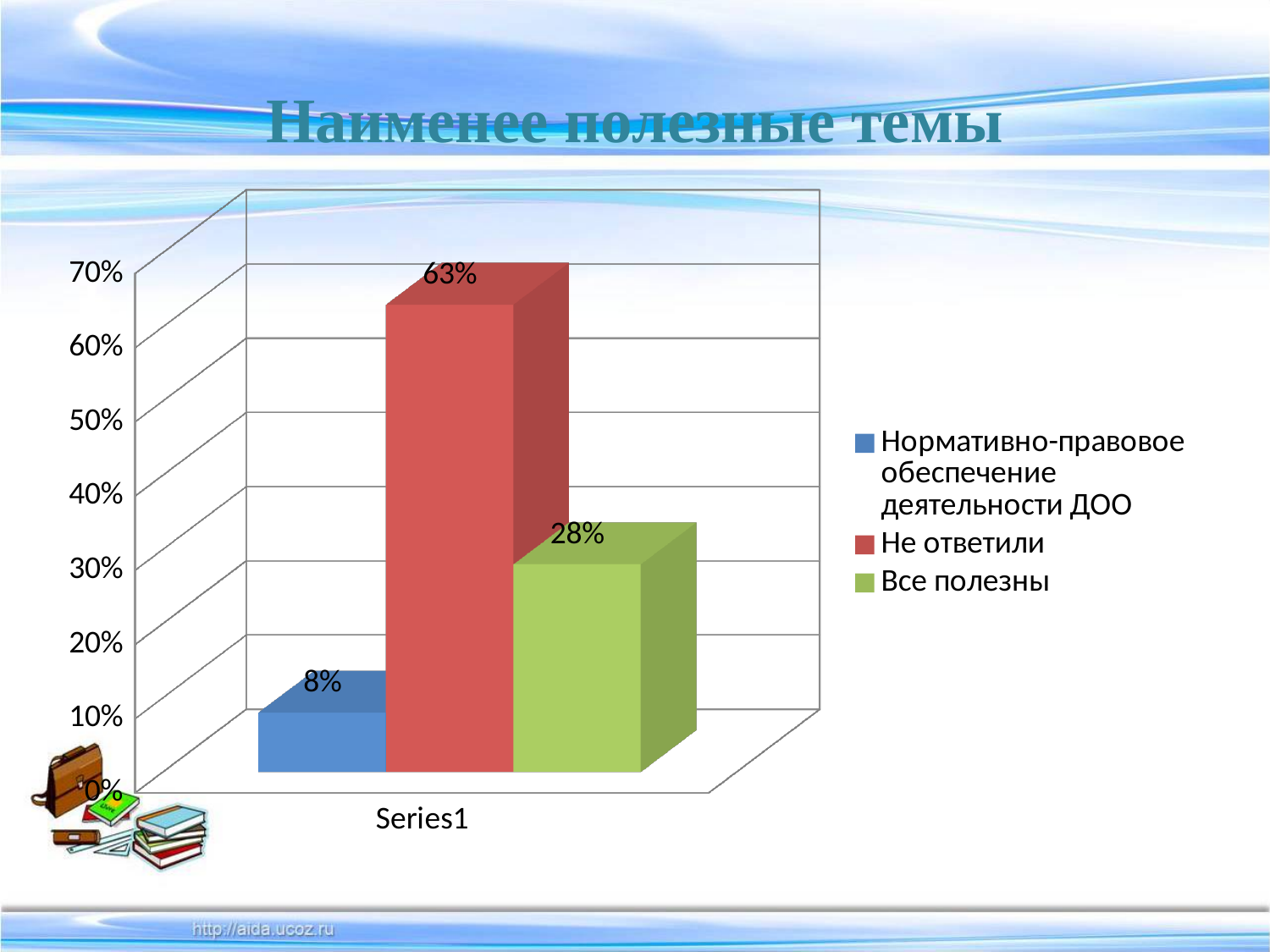
What kind of chart is shown on the slide? Bar chart What is the value for "Все полезны"? 28% What is the title of the slide? Наименее полезные темы Which series has the highest value? Не ответили What is the value for "Нормативно-правовое обеспечение деятельности ДОО"? 8% What is the difference between the values for "Все полезны" and "Нормативно-правовое обеспечение деятельности ДОО"? 20% What is the difference between the values for "Не ответили" and "Все полезны"? 35% How many series does the legend list? 3 Which is larger, the value for "Все полезны" or the value for "Нормативно-правовое обеспечение деятельности ДОО"? Все полезны What is the value for "Не ответили"? 63% Which series has the lowest value? Нормативно-правовое обеспечение деятельности ДОО What colour is the bar for "Не ответили"? Red